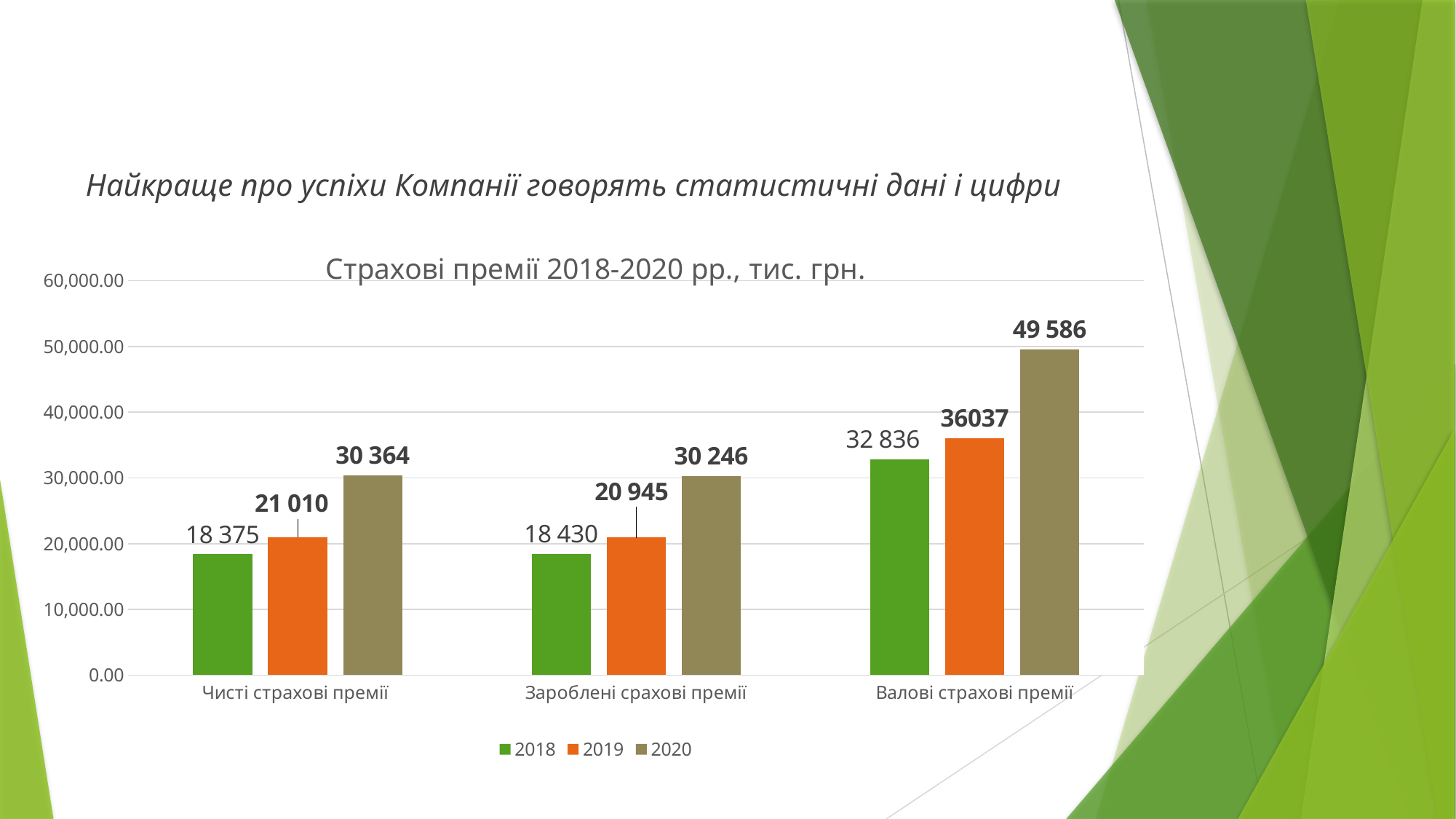
What is the value for 2018 in the category Валові страхові премії? 32 836 What kind of chart is shown on the slide? bar chart Which is larger: the 2019 value for Валові страхові премії or the 2020 value for Зароблені срахові премії? 2019 value for Валові страхові премії Is the 2020 value for Валові страхові премії greater or less than 50,000.00? less What is the difference between the 2020 and 2018 values for Чисті страхові премії? 11 989 Which category has the highest value for 2020? Валові страхові премії What is the value for 2020 in the category Чисті страхові премії? 30 364 How many series does the legend list? 3 What is the difference between the 2020 and 2018 values for Валові страхові премії? 16 750 Which category has the lowest value for 2018? Чисті страхові премії What is the value for 2019 in the category Зароблені срахові премії? 20 945 How many categories are shown on the x axis? 3